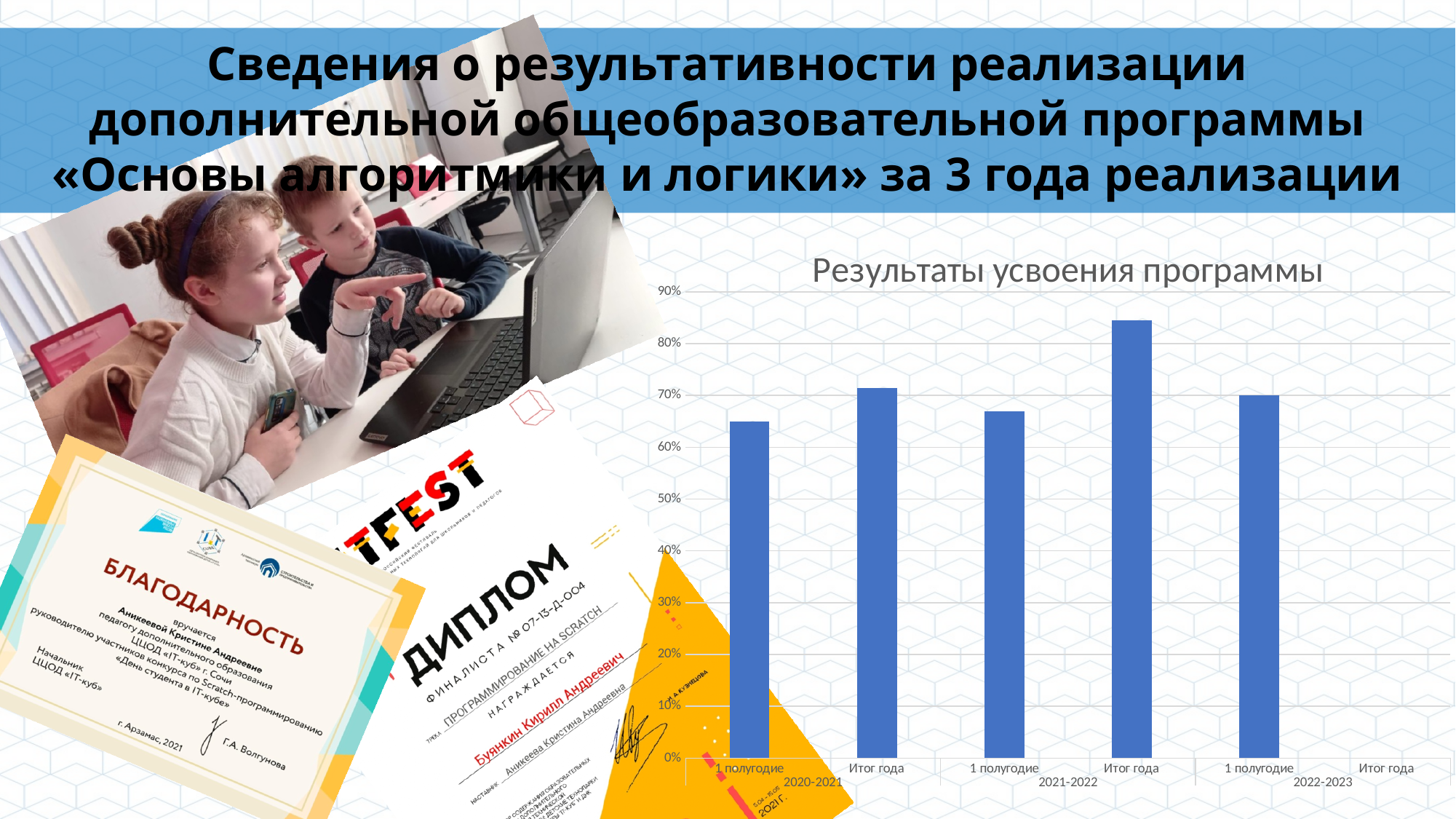
Is the value for 1 полугодие 2020-2021 greater or less than 70%? less Which category on the x axis has no bar plotted? Итог года 2022-2023 Is the value for 1 полугодие 2021-2022 greater or less than 70%? less Which is larger: the value for 1 полугодие 2021-2022 or the value for Итог года 2021-2022? Итог года 2021-2022 Is the value for 1 полугодие 2020-2021 greater or less than 60%? greater How many bars are plotted in the chart? 5 Which category has the highest bar in the chart? Итог года 2021-2022 Within the 2021-2022 year, does the value rise or fall from 1 полугодие to Итог года? rise What kind of chart is shown on the slide? bar chart What is the title of the chart? Результаты усвоения программы Which is larger: the value for 1 полугодие 2020-2021 or the value for Итог года 2020-2021? Итог года 2020-2021